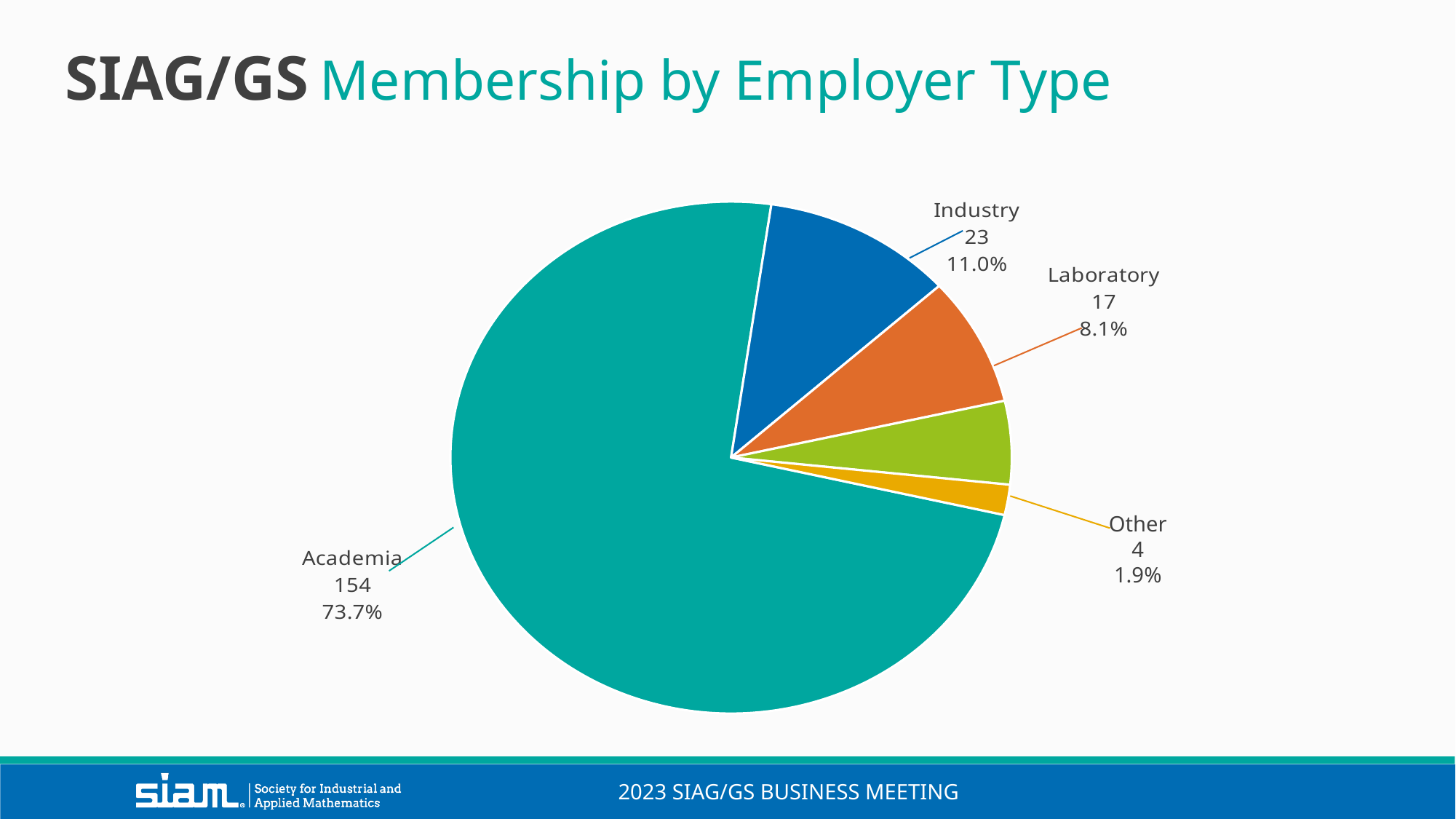
What kind of chart is shown on the slide? pie chart How many members are in the Other slice? 4 What share of the pie does Laboratory represent? 8.1% How many slices does the pie chart have? 5 How many members are in the Academia slice? 154 How many members are in the Laboratory slice? 17 What is the difference between the Industry and Laboratory member counts? 6 How many members are in the Industry slice? 23 What share of the pie does Academia represent? 73.7% Which has more members, Industry or Laboratory? Industry Which employer type has the largest slice? Academia Which labeled employer type has the smallest slice? Other